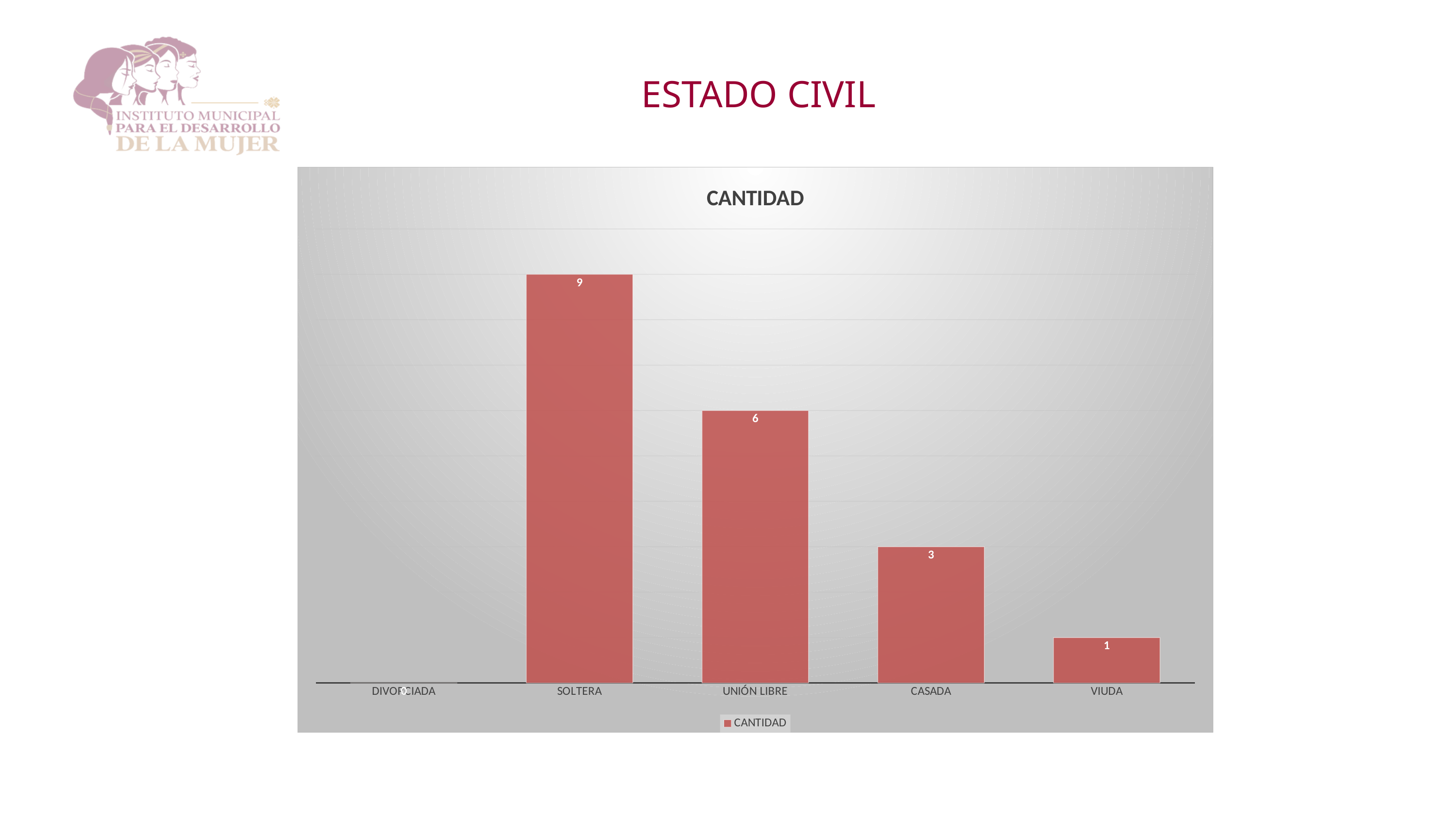
What is the difference between the values for SOLTERA and UNIÓN LIBRE? 3 What is the value for CASADA? 3 Which category has the highest value? SOLTERA Which is larger, the value for CASADA or the value for VIUDA? CASADA Which category has the lowest value? DIVORCIADA How many categories are shown on the x axis? 5 What is the value for DIVORCIADA? 0 What is the value for SOLTERA? 9 What is the value for UNIÓN LIBRE? 6 What is the title of the chart? CANTIDAD What kind of chart is shown on the slide? Bar chart What is the value for VIUDA? 1